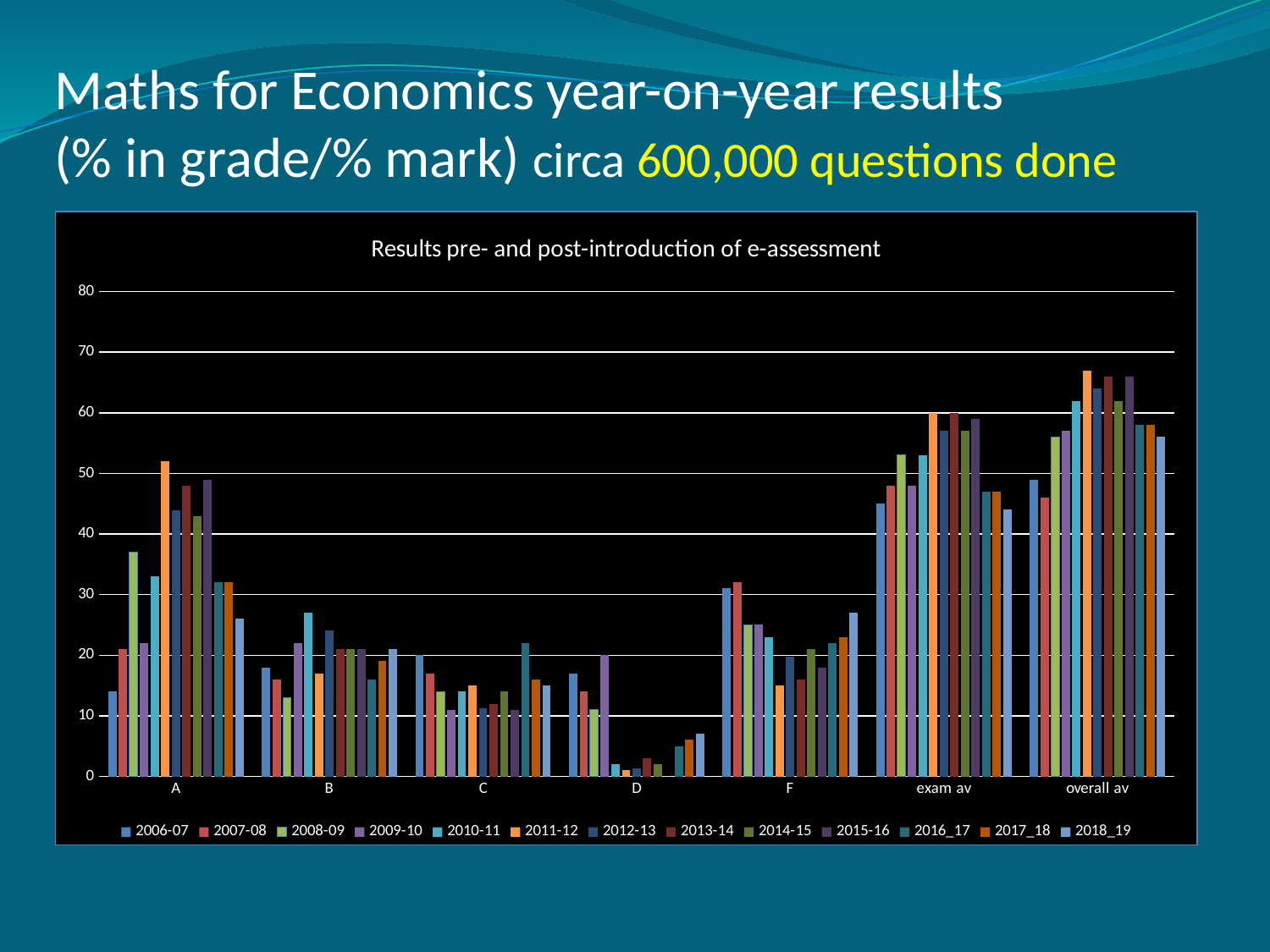
For the 2011-12 series, which category has the highest value? overall av What is the title of the chart? Results pre- and post-introduction of e-assessment In the exam av category, which is larger: the value for 2006-07 or the value for 2011-12? 2011-12 Is the value for 2006-07 in category A greater or less than 20? less How many categories are shown along the x axis of the chart? 7 Is the value for 2011-12 in the overall av category greater or less than 60? greater How many series does the chart's legend list? 13 Which series is listed first in the chart's legend? 2006-07 Is the value for 2010-11 in category B greater or less than 20? greater What kind of chart is shown on the slide? bar chart